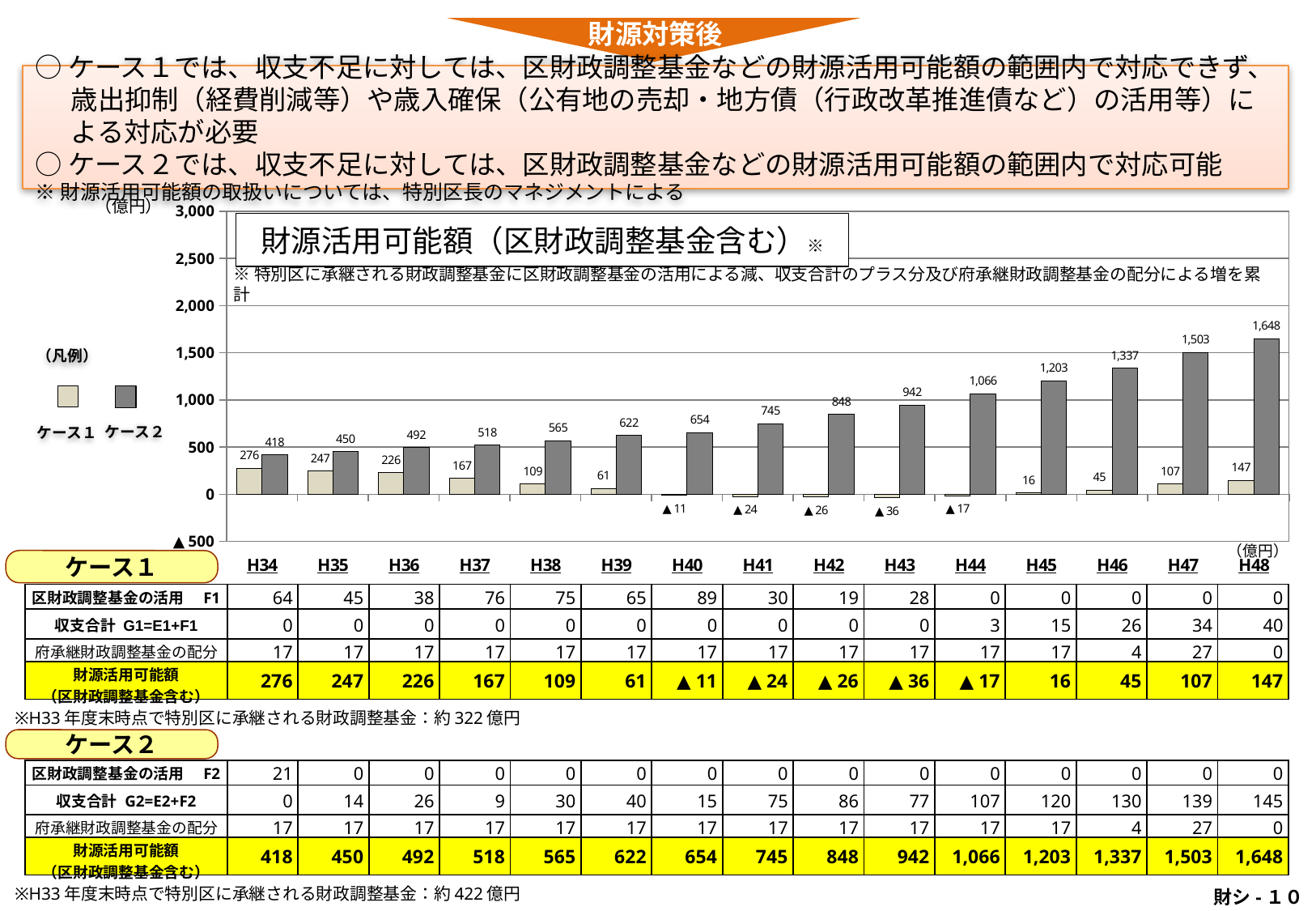
What is the difference between the ケース2 and ケース1 values in H48? 1,501 What kind of chart is shown on the slide? bar chart What is the value for ケース2 in H48? 1,648 What is the value for ケース1 in H41? ▲ 24 What is the value for ケース1 in H34? 276 In H34, which is larger, ケース1 or ケース2? ケース2 Do the ケース2 values rise or fall from H34 to H48? rise Is the value for ケース2 in H44 greater or less than 1,000? greater In which year is the ケース2 value highest? H48 How many years are shown on the x axis of the chart? 15 In which year is the ケース1 value lowest? H43 How many series does the legend list? 2